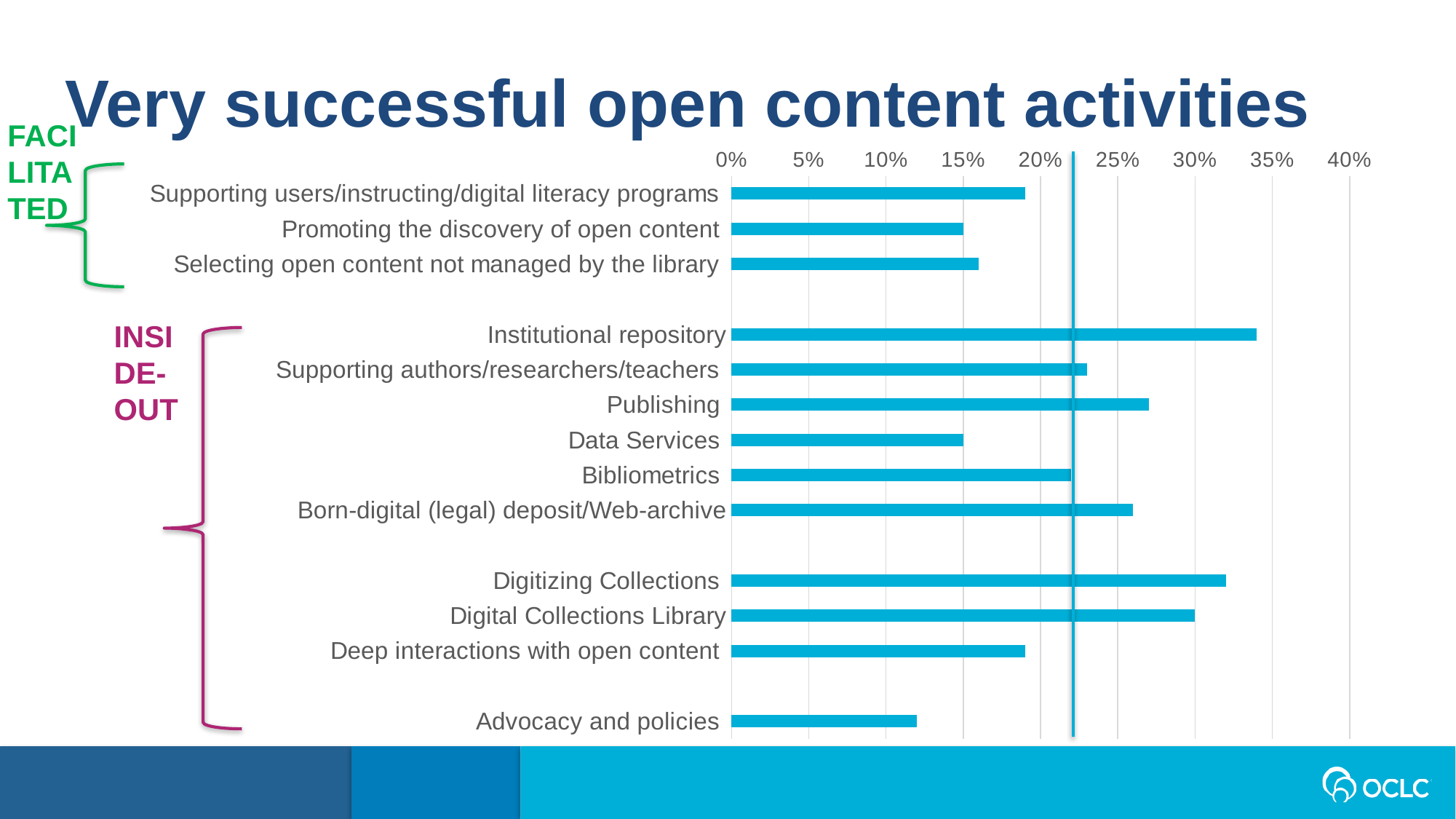
What kind of chart is shown on the slide? bar chart Is the value for Supporting users/instructing/digital literacy programs greater or less than 20%? less What is the title of the chart on the slide? Very successful open content activities What is the highest percentage shown on the chart's horizontal axis? 40% Is the value for Institutional repository greater or less than 30%? greater Which activity has the highest value in the chart? Institutional repository Which has the larger value: Institutional repository or Publishing? Institutional repository Which activity has the lowest value in the chart? Advocacy and policies How many activities (categories) are plotted in the chart? 13 Which has the larger value: Digitizing Collections or Deep interactions with open content? Digitizing Collections Is the value for Publishing greater or less than 25%? greater